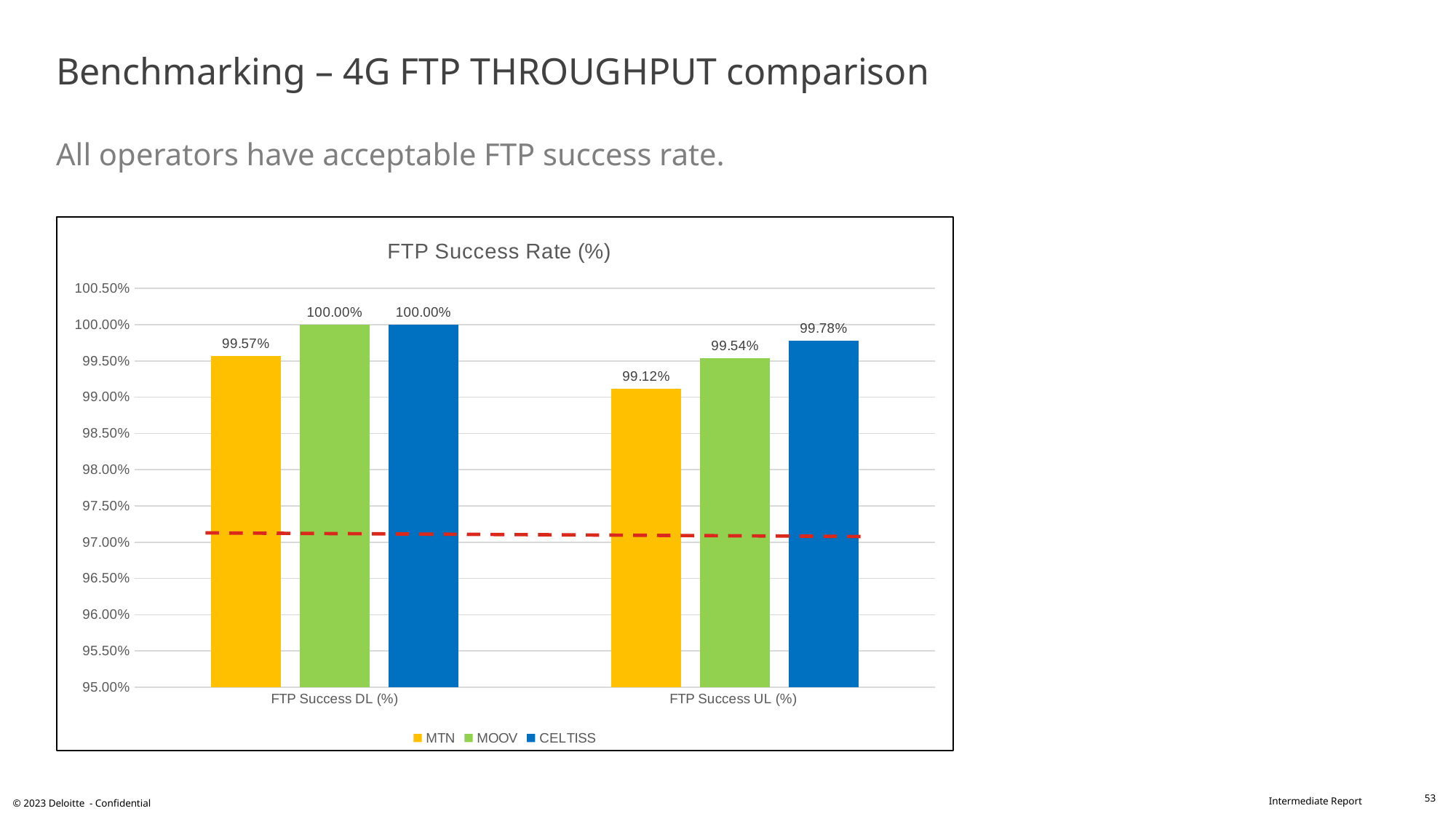
How many categories are shown on the x axis? 2 Which operator has the highest FTP Success UL (%)? CELTISS Which operator has the lowest FTP Success UL (%)? MTN What is the FTP Success UL (%) value for MOOV? 99.54% What kind of chart is shown on the slide? Bar chart Which is larger: MTN's FTP Success DL (%) or MTN's FTP Success UL (%)? FTP Success DL (%) What is the title of the chart? FTP Success Rate (%) What is the difference between MOOV and MTN for FTP Success DL (%)? 0.43% What is the difference between CELTISS and MTN for FTP Success UL (%)? 0.66% What is the FTP Success UL (%) value for CELTISS? 99.78% What is the FTP Success DL (%) value for MTN? 99.57% How many series does the legend list? 3